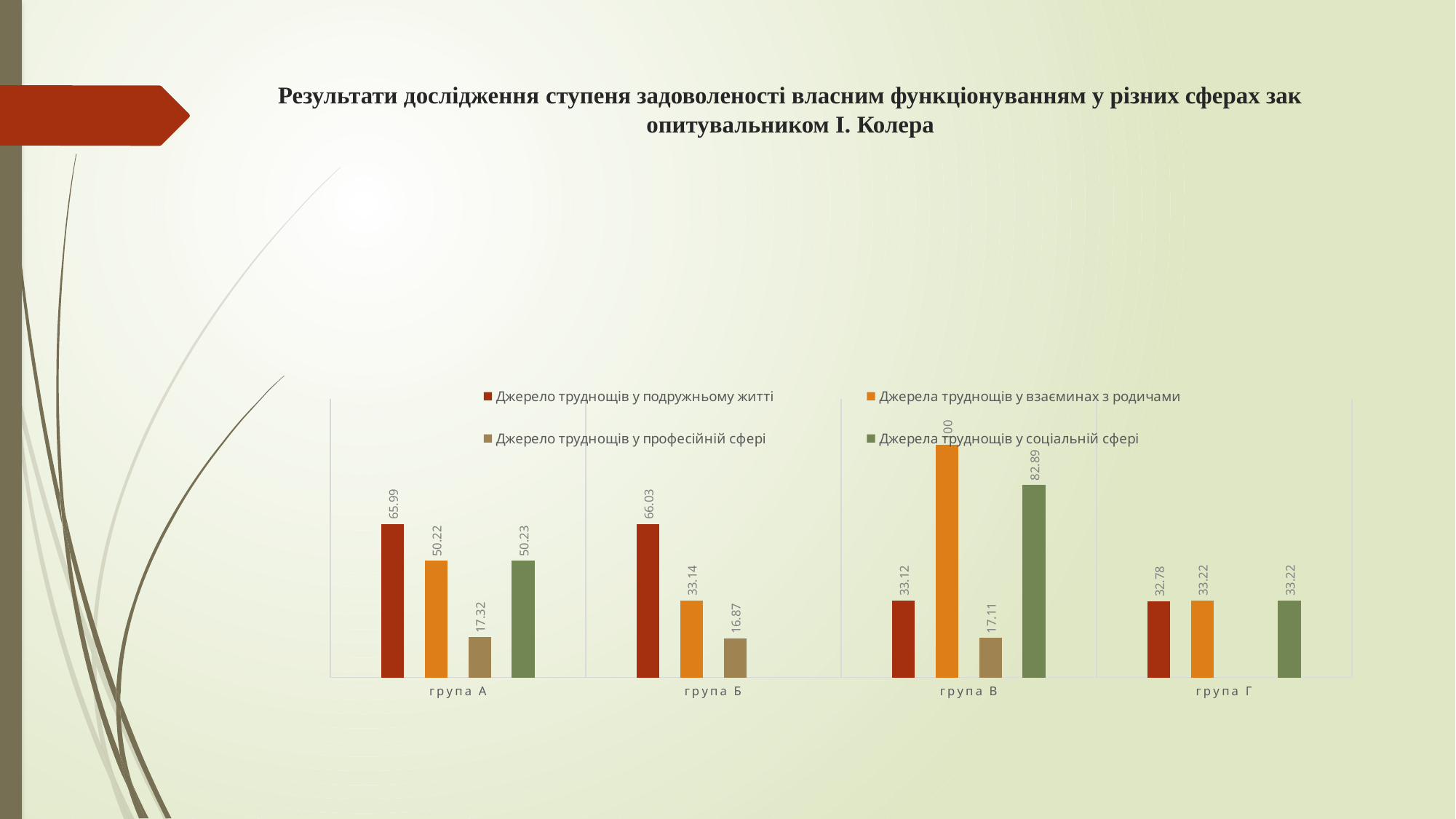
What is the value of "Джерело труднощів у подружньому житті" for група А? 65.99 What is the difference between "Джерело труднощів у подружньому житті" and "Джерела труднощів у взаєминах з родичами" for група Б? 32.89 Which is larger: "Джерело труднощів у подружньому житті" for група А or for група Г? група А What kind of chart is shown on the slide? bar chart How many groups are shown on the x axis? 4 What is the value of "Джерело труднощів у професійній сфері" for група Б? 16.87 Which series has the lowest value in група А? Джерело труднощів у професійній сфері What is the value of "Джерела труднощів у соціальній сфері" for група В? 82.89 Which series is shown in orange in the legend? Джерела труднощів у взаєминах з родичами Which series has the highest value in група В? Джерела труднощів у взаєминах з родичами How many series does the legend list? 4 What is the value of "Джерела труднощів у взаєминах з родичами" for група Г? 33.22